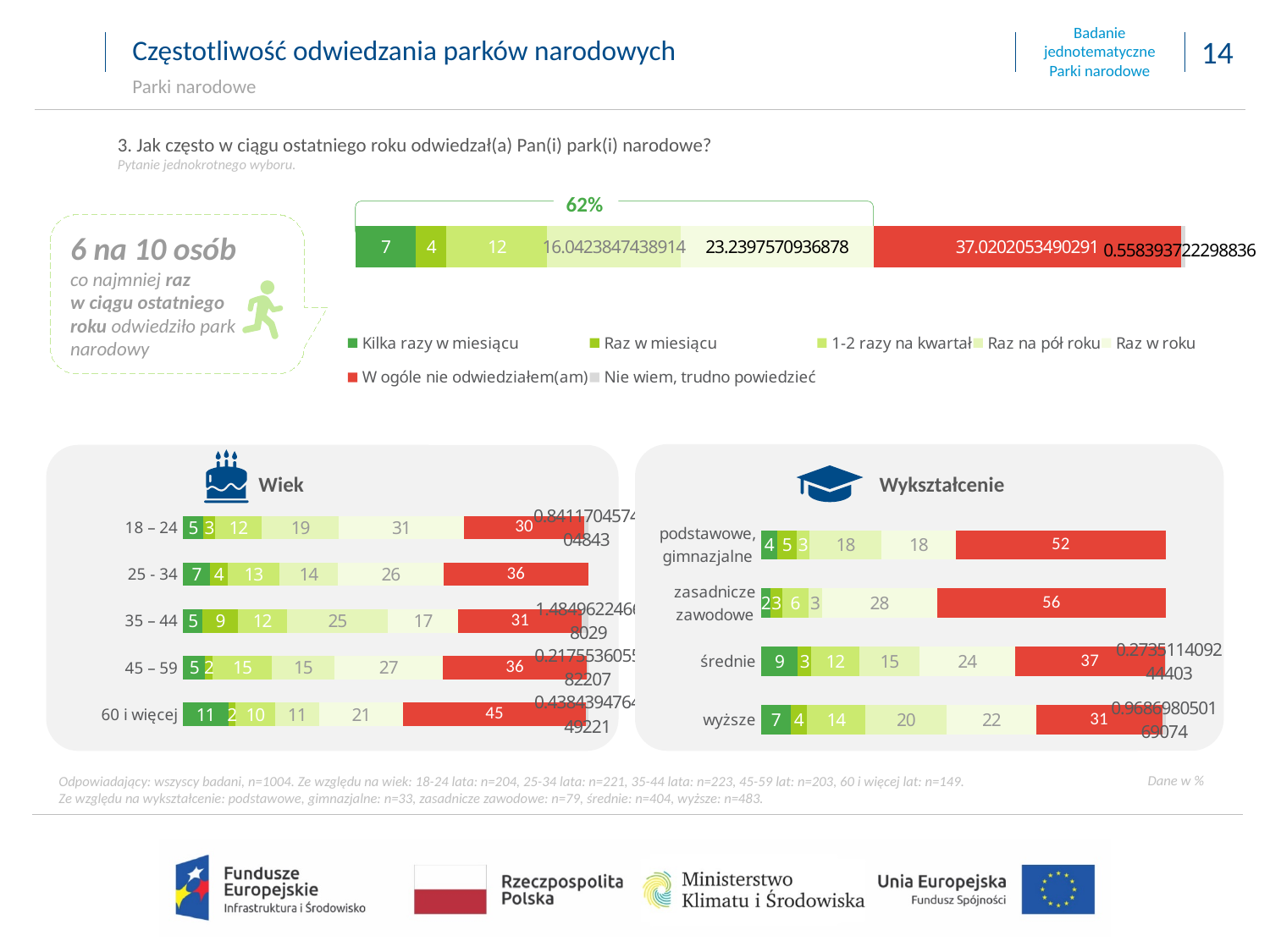
What kind of chart is the 'Wiek' chart? stacked bar chart In the top stacked bar chart, what is the value for 'Kilka razy w miesiącu'? 7 In the top stacked bar chart, what is the value for 'W ogóle nie odwiedziałem(am)'? 37.0202053490291 In the 'Wiek' chart, what is the value of the first (dark green) segment for '25 - 34'? 7 In the 'Wykształcenie' chart, what is the value of the red segment for 'zasadnicze zawodowe'? 56 How many series does the legend of the top stacked bar chart list? 7 In the 'Wykształcenie' chart, what is the difference between the red segment values for 'zasadnicze zawodowe' and 'wyższe'? 25 In the 'Wykształcenie' chart, is the red segment value for 'średnie' larger or smaller than that for 'podstawowe, gimnazjalne'? smaller In the 'Wiek' chart, which age group has the highest value for the red 'W ogóle nie odwiedziałem(am)' segment? 60 i więcej How many age categories are shown in the 'Wiek' chart? 5 In the 'Wykształcenie' chart, which education group has the lowest value for the red 'W ogóle nie odwiedziałem(am)' segment? wyższe In the 'Wiek' chart, what is the value of the red 'W ogóle nie odwiedziałem(am)' segment for '60 i więcej'? 45